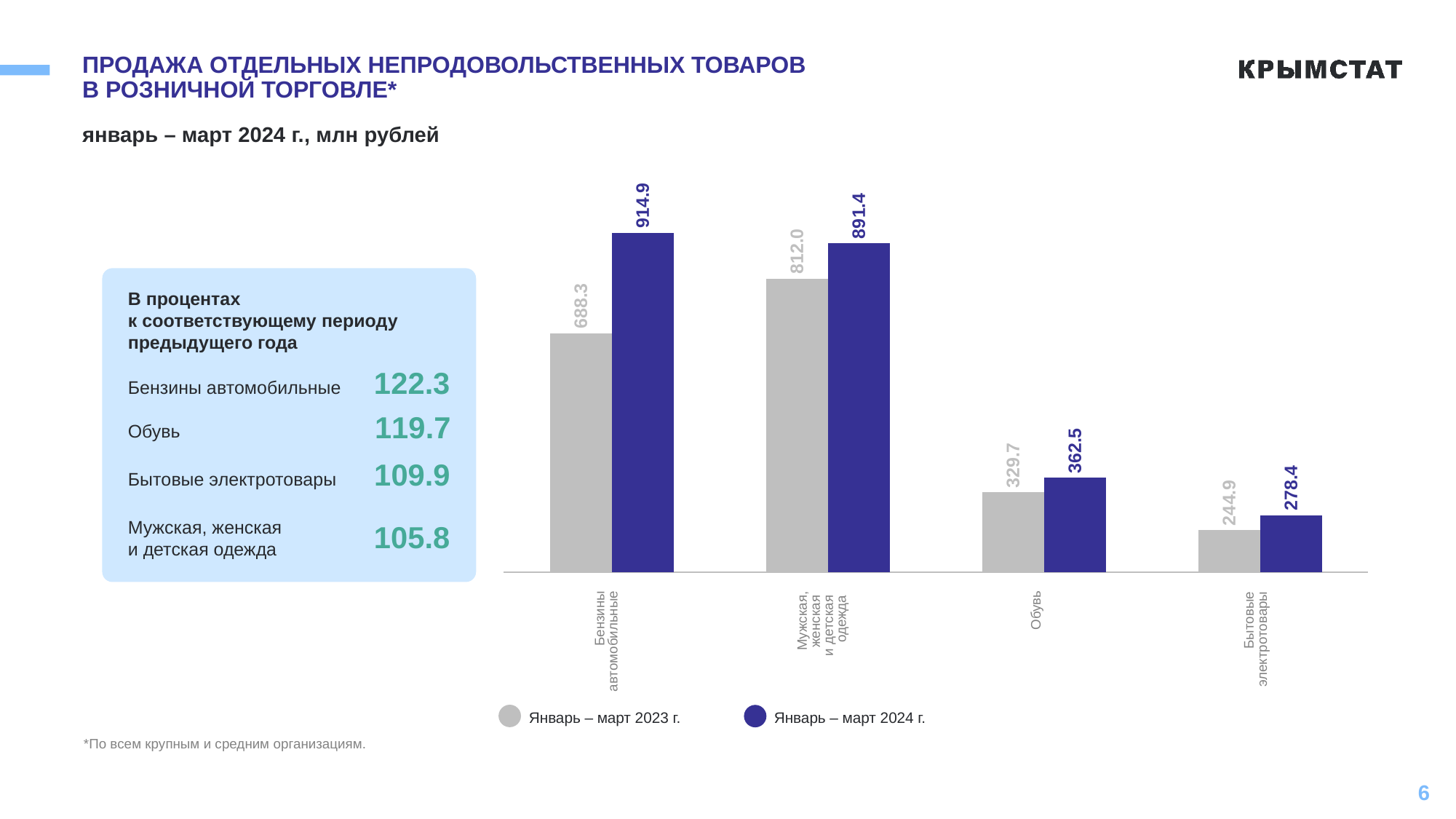
Which category has the lowest value in the Январь – март 2023 г. series? Бытовые электротовары Which category has the highest value in the Январь – март 2024 г. series? Бензины автомобильные How many series does the chart legend list? 2 What is the value for Мужская, женская и детская одежда in the Январь – март 2023 г. series? 812.0 What is the difference between the Январь – март 2024 г. and Январь – март 2023 г. values for Обувь? 32.8 Which is larger in the Январь – март 2023 г. series: Бензины автомобильные or Мужская, женская и детская одежда? Мужская, женская и детская одежда What is the value for Бытовые электротовары in the Январь – март 2024 г. series? 278.4 What is the value for Бензины автомобильные in the Январь – март 2024 г. series? 914.9 What is the difference between the Январь – март 2024 г. and Январь – март 2023 г. values for Бензины автомобильные? 226.6 What is the value for Обувь in the Январь – март 2023 г. series? 329.7 What kind of chart is shown on the slide? Bar chart How many categories are shown on the x axis of the chart? 4